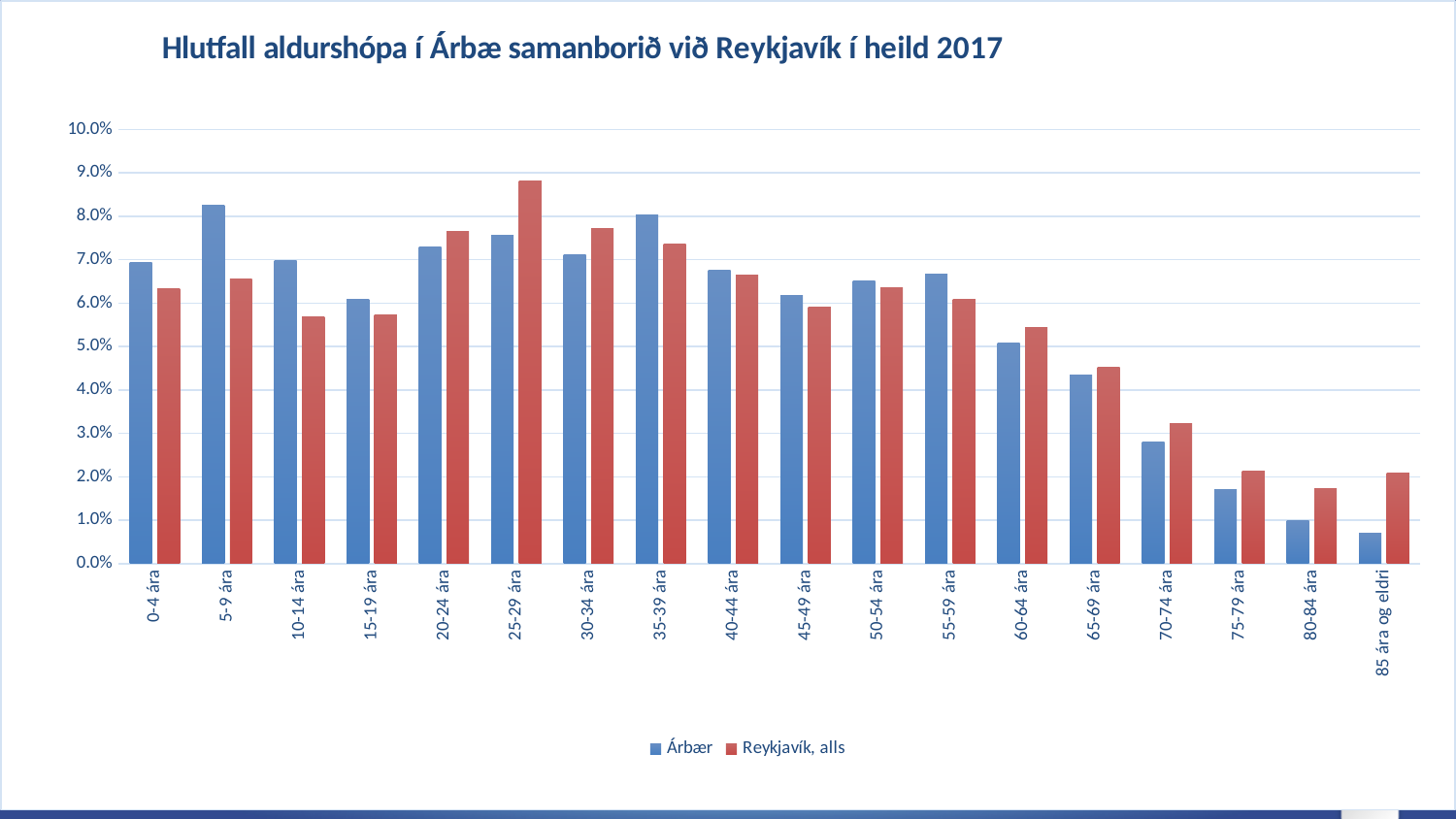
For the 25-29 ára group, which series has the larger value, Árbær or Reykjavík, alls? Reykjavík, alls Is the Árbær value for 70-74 ára greater or less than 3.0%? less What colour are the bars for the Reykjavík, alls series? red Which age group has the lowest value for Reykjavík, alls? 80-84 ára What kind of chart is shown on the slide? bar chart Is the Árbær value for 0-4 ára greater or less than 6.0%? greater Which age group has the highest value for Reykjavík, alls? 25-29 ára Do the Árbær values rise or fall along the x axis from 35-39 ára to 85 ára og eldri? fall For the 5-9 ára group, which series has the larger value, Árbær or Reykjavík, alls? Árbær Which age group has the lowest value for Árbær? 85 ára og eldri How many age-group categories are shown on the x axis? 18 How many series does the legend list? 2